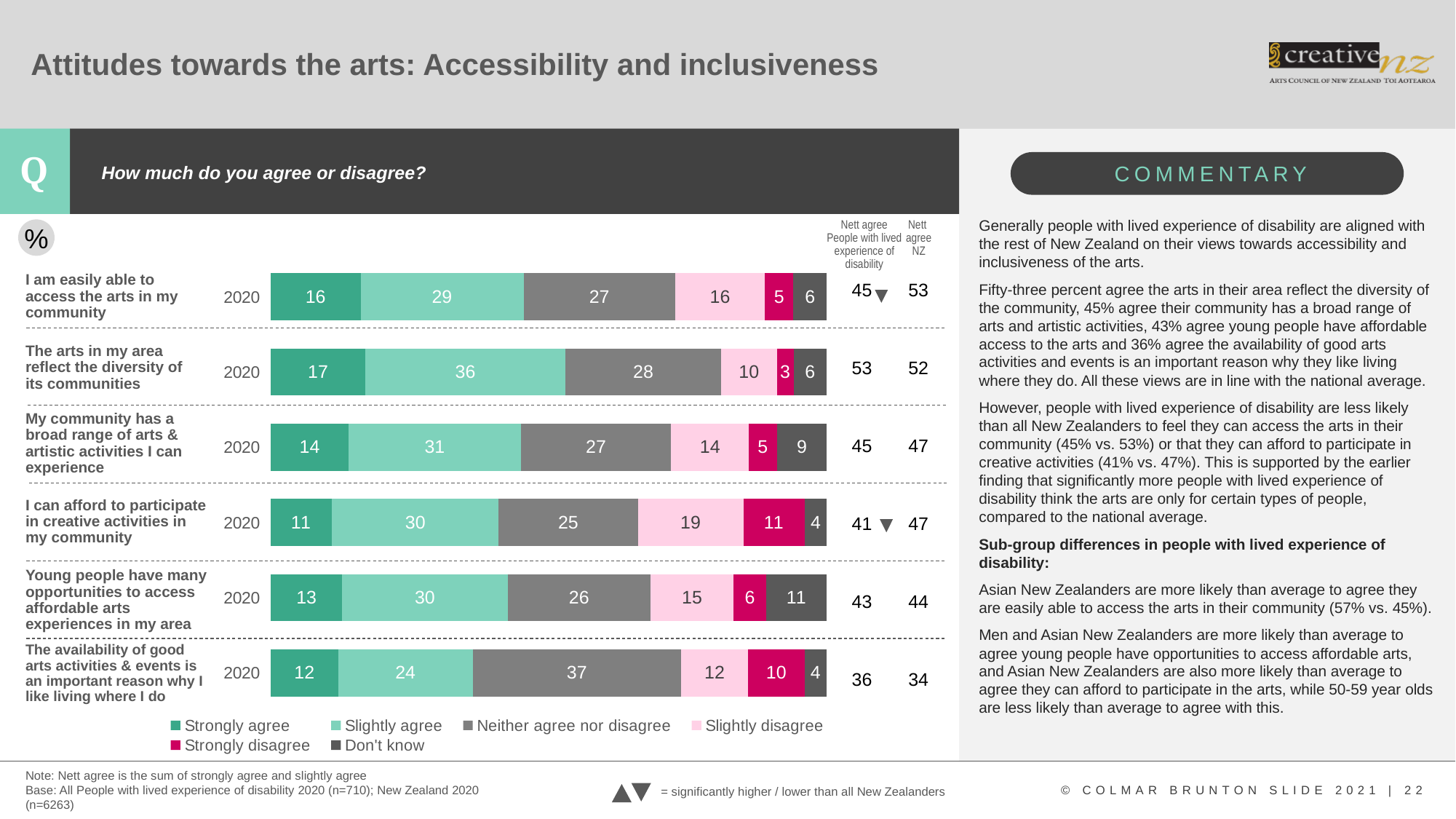
How many series does the legend list? 6 What is the difference between the 'Slightly agree' value for 'The arts in my area reflect the diversity of its communities' and for 'The availability of good arts activities & events is an important reason why I like living where I do'? 12 What percentage strongly agree that the arts in their area reflect the diversity of its communities? 17 How many statements are shown in the chart? 6 Which has a larger 'Strongly disagree' value: 'I can afford to participate in creative activities in my community' or 'Young people have many opportunities to access affordable arts experiences in my area'? I can afford to participate in creative activities in my community Which statement has the highest 'Strongly agree' value? The arts in my area reflect the diversity of its communities Which statement has the highest 'Don't know' value? Young people have many opportunities to access affordable arts experiences in my area What is the Nett agree for people with lived experience of disability for 'I can afford to participate in creative activities in my community'? 41 What is the difference between the Nett agree NZ value and the Nett agree for people with lived experience of disability for 'I am easily able to access the arts in my community'? 8 What is the 'Neither agree nor disagree' value for 'The availability of good arts activities & events is an important reason why I like living where I do'? 37 What kind of chart is shown on the slide? Stacked bar chart Which statement has the lowest 'Strongly agree' value? I can afford to participate in creative activities in my community